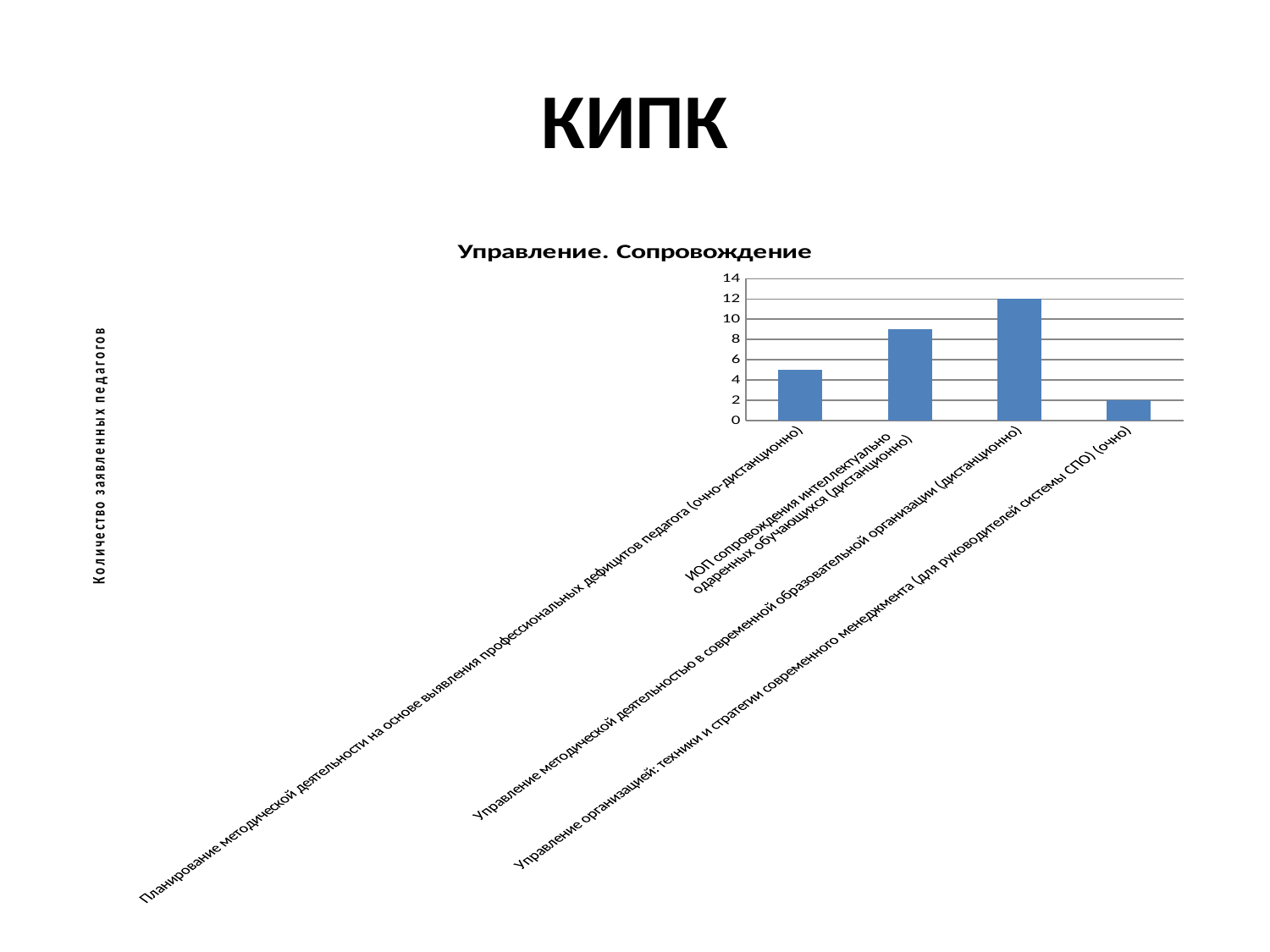
Which category has the lowest value? Управление организацией: техники и стратегии современного менеджмента (для руководителей системы СПО) (очно) What is the title of the chart? Управление. Сопровождение Which is larger: the value for "ИОП сопровождения интеллектуально одаренных обучающихся (дистанционно)" or the value for "Планирование методической деятельности на основе выявления профессиональных дефицитов педагога (очно-дистанционно)"? ИОП сопровождения интеллектуально одаренных обучающихся (дистанционно) Which category has the highest value? Управление методической деятельностью в современной образовательной организации (дистанционно) What kind of chart is shown on the slide? bar chart What is the value for "Управление организацией: техники и стратегии современного менеджмента (для руководителей системы СПО) (очно)"? 2 What is the label of the vertical axis? Количество заявленных педагогов What is the value for "Управление методической деятельностью в современной образовательной организации (дистанционно)"? 12 Is the value for "ИОП сопровождения интеллектуально одаренных обучающихся (дистанционно)" greater or less than 10? less What is the difference between the highest and lowest values in the chart? 10 How many categories (bars) does the chart show? 4 Is the value for "Планирование методической деятельности на основе выявления профессиональных дефицитов педагога (очно-дистанционно)" greater or less than 4? greater